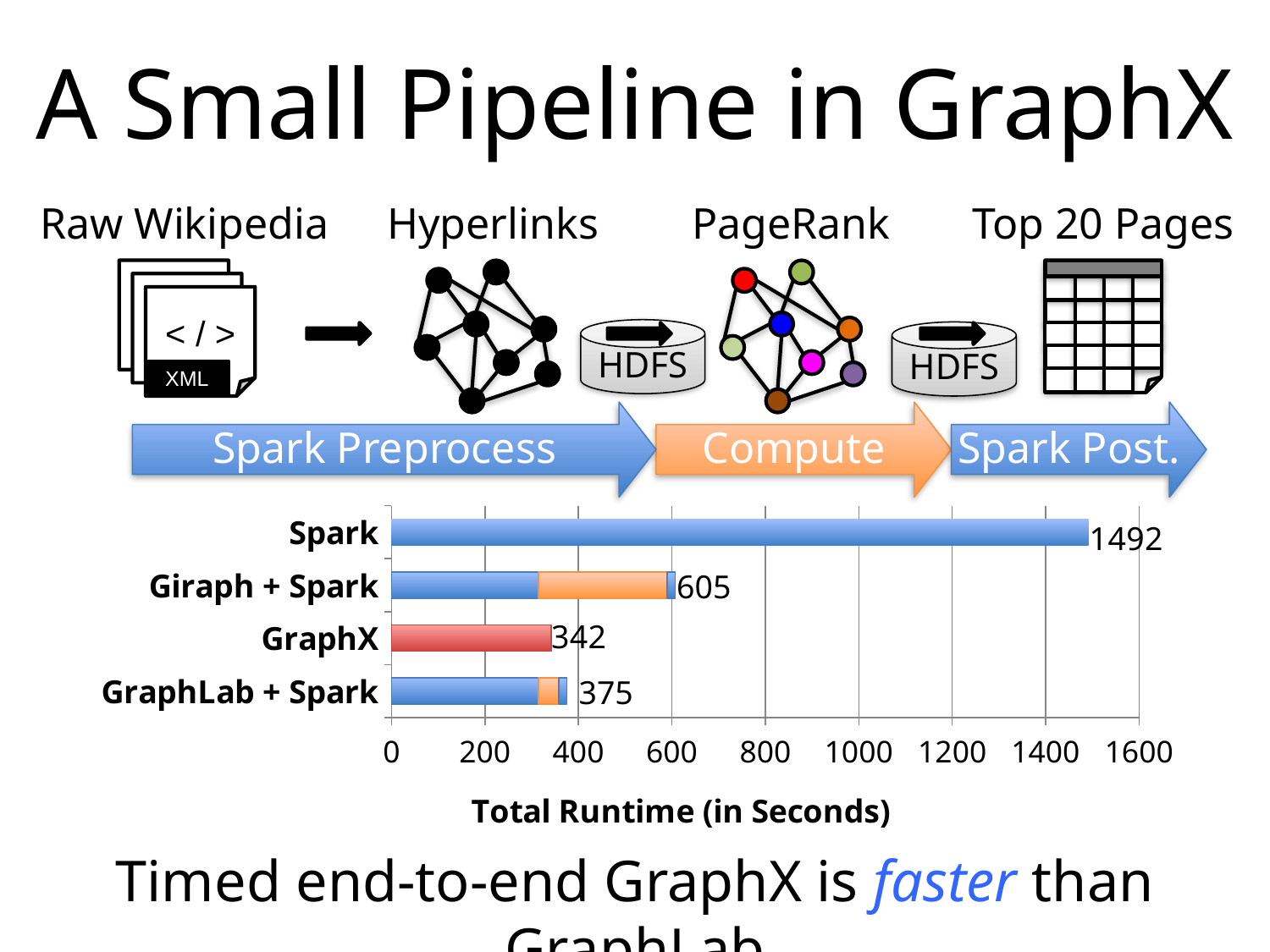
Which system has the lowest total runtime? GraphX What is the total runtime shown for GraphLab + Spark? 375 What is the difference in total runtime between GraphLab + Spark and GraphX? 33 Which system has the highest total runtime? Spark How many systems are compared in the bar chart? 4 What is the total runtime shown for GraphX? 342 What is the title of the horizontal axis of the chart? Total Runtime (in Seconds) What kind of chart is used to show the total runtimes? Bar chart Which has a larger total runtime, Giraph + Spark or GraphLab + Spark? Giraph + Spark What is the total runtime shown for Giraph + Spark? 605 What is the total runtime shown for Spark? 1492 What is the difference in total runtime between Spark and GraphX? 1150